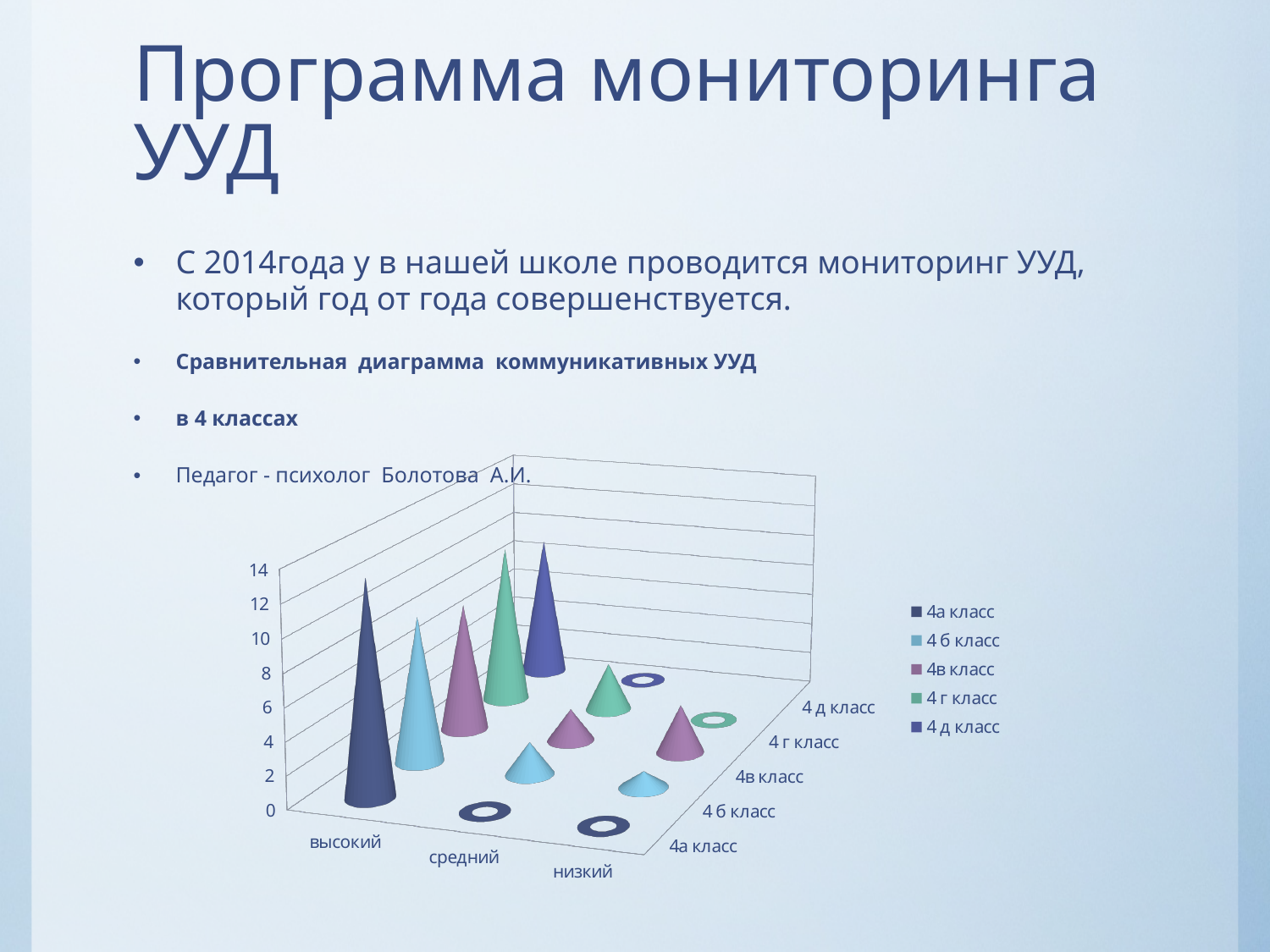
How many series does the legend list? 5 Is the value for 4а класс in the низкий category greater or less than 2? less How many categories are shown on the horizontal axis? 3 Which series is listed first in the legend? 4а класс What kind of chart is shown on the slide? bar chart Is the value for 4а класс in the высокий category greater or less than 8? greater For 4а класс, which is larger: the value for высокий or the value for низкий? высокий Do the values for 4а класс rise or fall from высокий to низкий? fall Which category has the highest value for 4а класс? высокий What is the maximum value shown on the vertical axis? 14 Which category has the lowest value for 4а класс? средний and низкий (both 0)